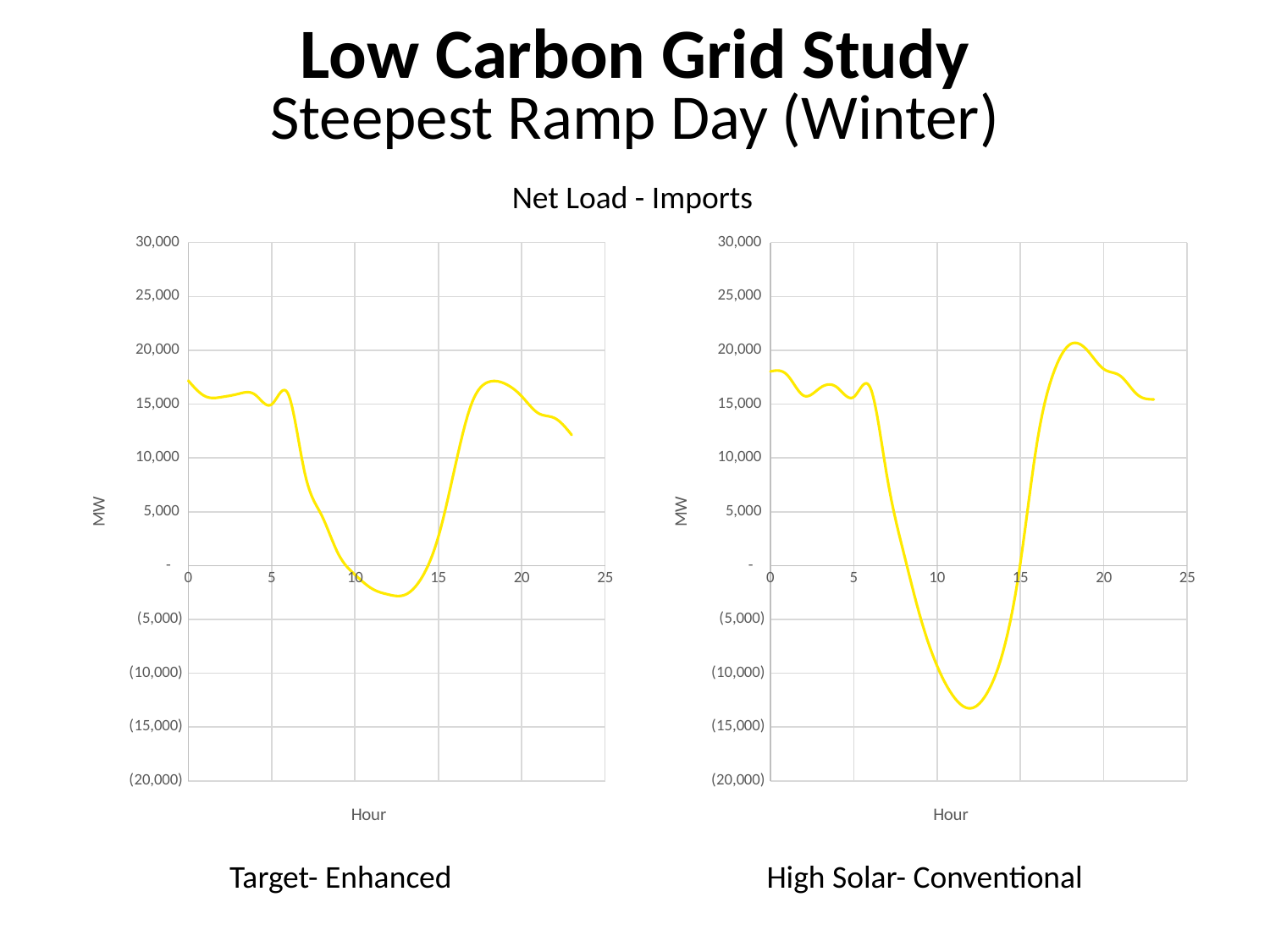
On the High Solar- Conventional chart, is the value at hour 18 greater or less than 15,000? greater On the Target- Enhanced chart, do the values rise or fall between hour 13 and hour 18? rise What is the y-axis label on the High Solar- Conventional chart? MW Which chart reaches the lower minimum value, Target- Enhanced or High Solar- Conventional? High Solar- Conventional What is the shared title above the two charts? Net Load - Imports On the Target- Enhanced chart, is the value at hour 0 greater or less than 15,000? greater What kind of chart is the Target- Enhanced chart on the left? line chart On the Target- Enhanced chart, is the value at hour 23 greater or less than 15,000? less On the High Solar- Conventional chart, do the values rise or fall between hour 6 and hour 12? fall